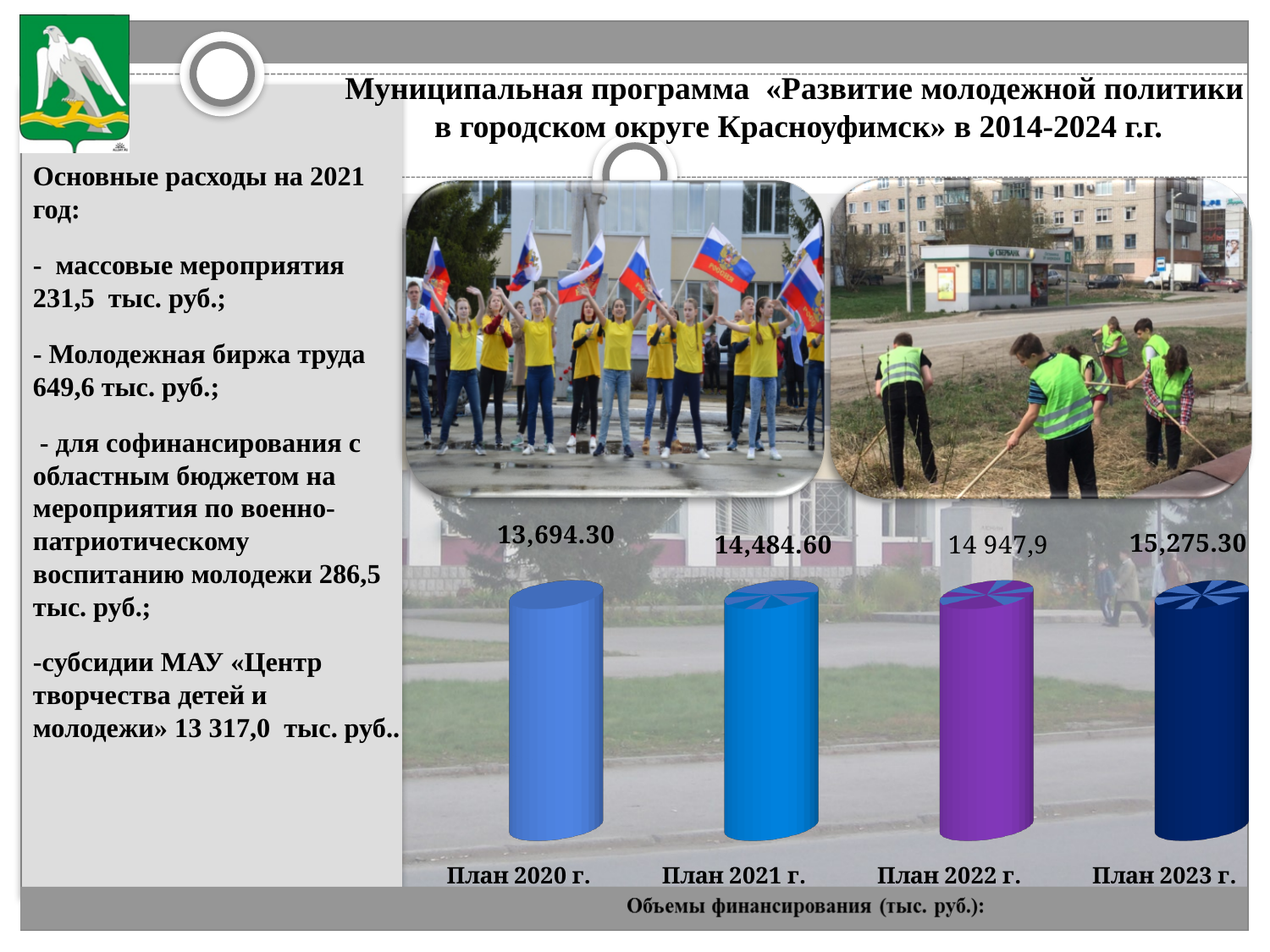
What is the value for План 2021 г.? 14,484.60 Do the values rise or fall from План 2020 г. to План 2023 г.? rise What is the value for План 2020 г.? 13,694.30 What is the value for План 2023 г.? 15,275.30 What is the difference between the values for План 2021 г. and План 2020 г.? 790.30 Which is larger, the value for План 2022 г. or the value for План 2021 г.? План 2022 г. Which category has the lowest value? План 2020 г. What is the difference between the values for План 2023 г. and План 2020 г.? 1,581.00 Which category has the highest value? План 2023 г. What kind of chart is shown on the slide? bar chart How many categories are shown in the chart? 4 What is the value for План 2022 г.? 14 947,9